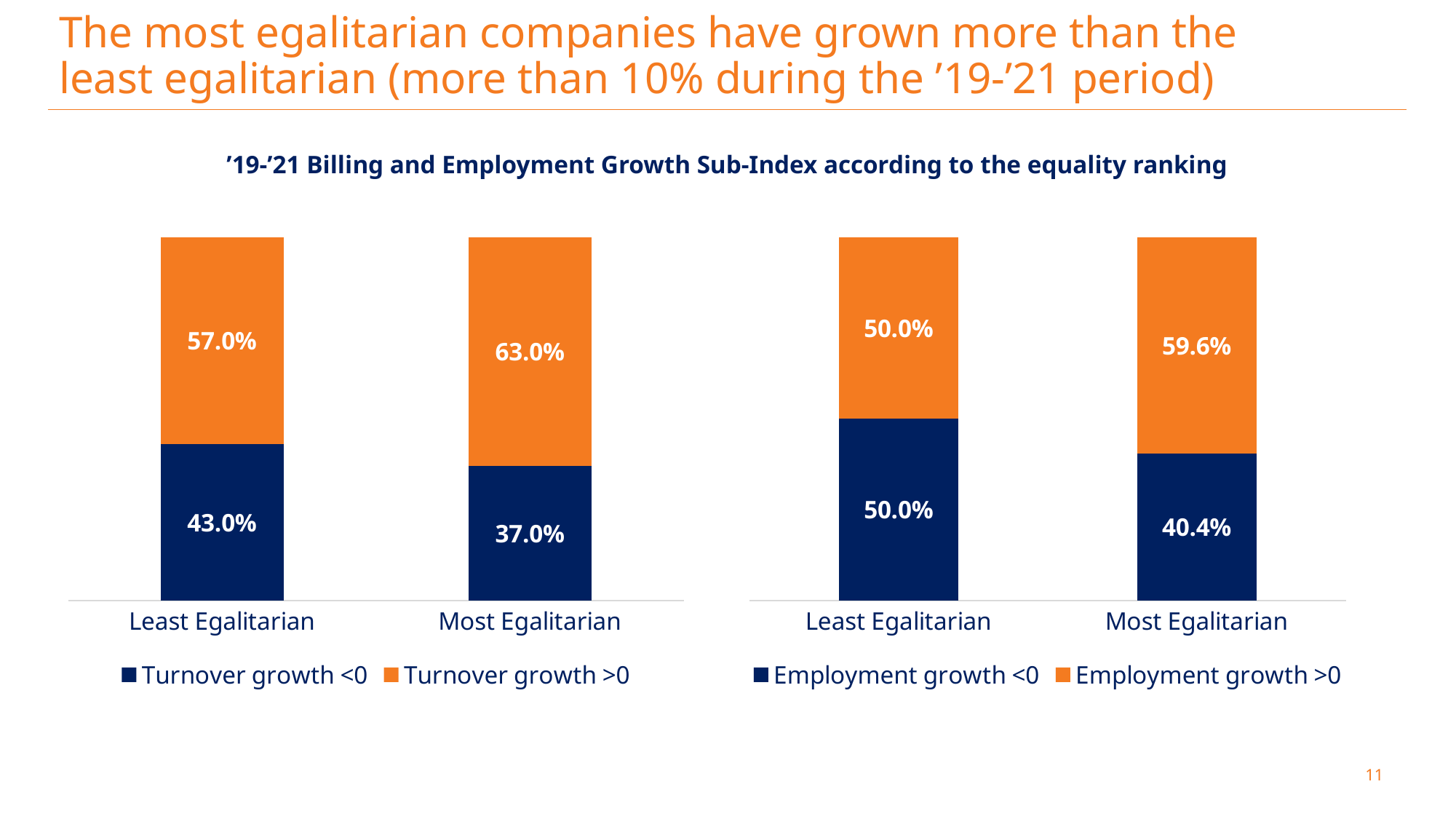
In the left chart (Turnover growth), what is the value for Turnover growth >0 for Most Egalitarian? 63.0% In the left chart (Turnover growth), what is the value for Turnover growth <0 for Least Egalitarian? 43.0% In the right chart (Employment growth), what is the value for Employment growth >0 for Most Egalitarian? 59.6% In the right chart (Employment growth), which category has the lower Employment growth <0 share? Most Egalitarian In the left chart (Turnover growth), what is the total of the stacked bar for Least Egalitarian? 100.0% In the left chart (Turnover growth), what is the difference between the Turnover growth >0 values for Most Egalitarian and Least Egalitarian? 6.0% In the right chart (Employment growth), what is the difference between the Employment growth >0 values for Most Egalitarian and Least Egalitarian? 9.6% What kind of chart is the left chart (Turnover growth)? Stacked bar chart How many series does the legend of the right chart (Employment growth) list? 2 In the left chart (Turnover growth), which category has the higher Turnover growth >0 share? Most Egalitarian In the right chart (Employment growth), is the Employment growth <0 value for Least Egalitarian larger or smaller than the Employment growth <0 value for Most Egalitarian? larger In the right chart (Employment growth), what is the value for Employment growth <0 for Least Egalitarian? 50.0%